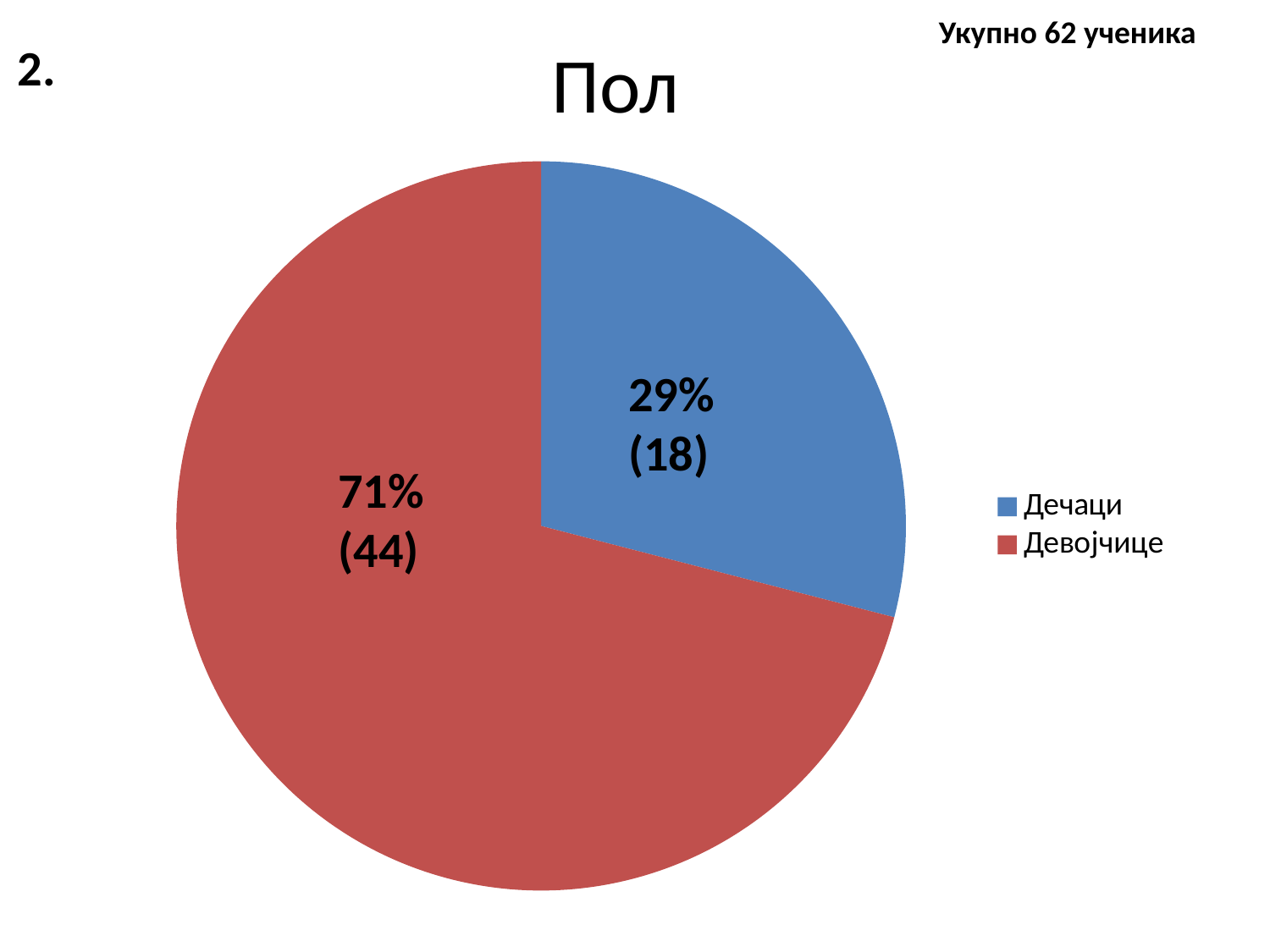
Which is larger, the Дечаци slice or the Девојчице slice? Девојчице What percentage of the pie does Девојчице represent? 71% Which category has the smallest slice of the pie? Дечаци How many categories does the pie chart have? 2 Which category has the largest slice of the pie? Девојчице How many students are in the Девојчице slice? 44 What percentage of the pie does Дечаци represent? 29% What is the title of the chart? Пол What is the difference in the number of students between Девојчице and Дечаци? 26 What kind of chart is shown on the slide? pie chart How many students are in the Дечаци slice? 18 What is the total number of students shown in the chart? 62